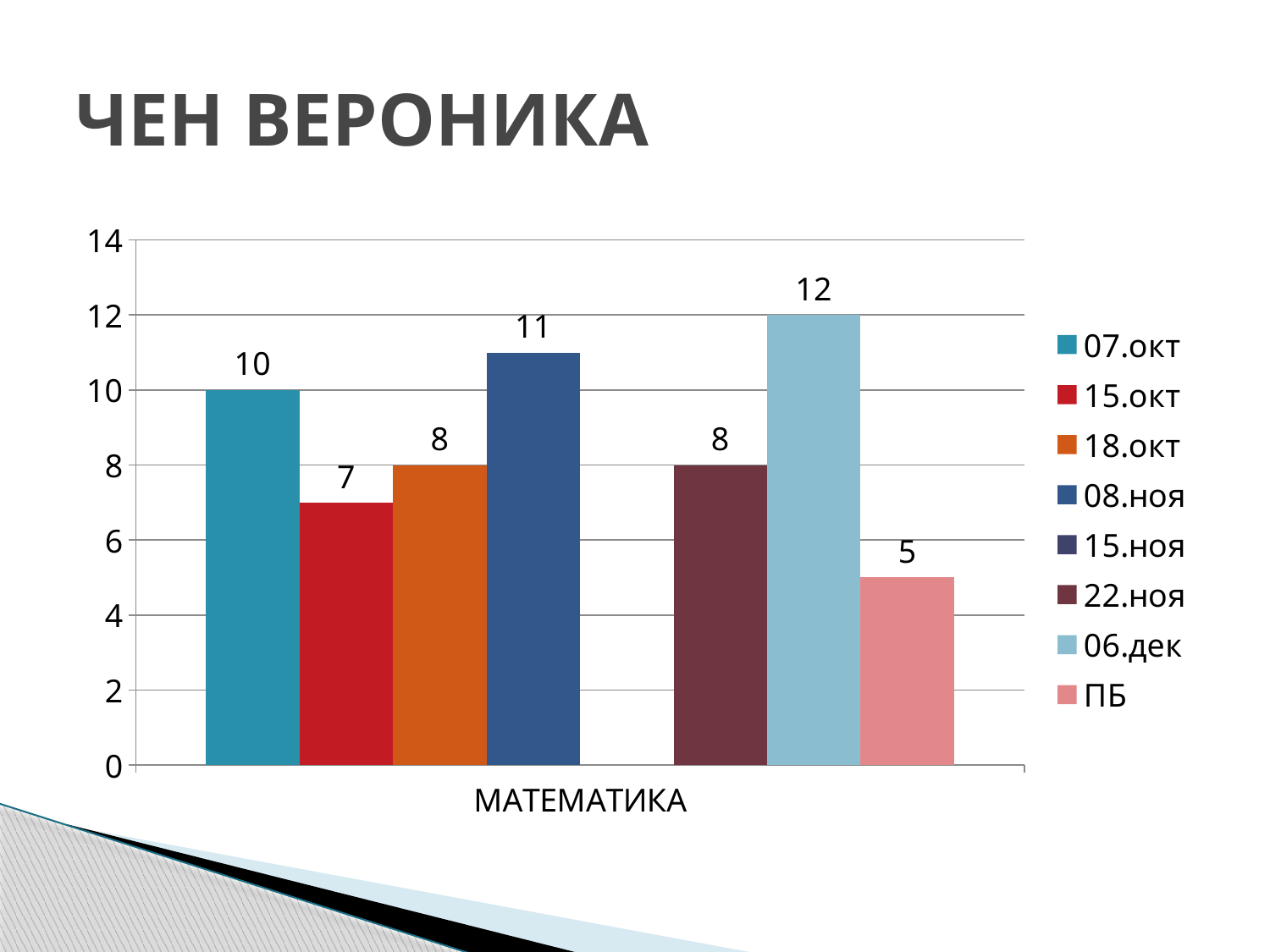
Which is larger, the value for 07.окт or the value for 08.ноя? 08.ноя What is the value for 06.дек? 12 What kind of chart is shown on the slide? bar chart What is the value for 15.окт? 7 What is the value for ПБ? 5 What is the value for 07.окт in the МАТЕМАТИКА chart? 10 What is the value for 08.ноя? 11 How many series does the legend list? 8 What is the difference between the values for 06.дек and ПБ? 7 Which series has the highest value? 06.дек What is the category label shown on the x axis? МАТЕМАТИКА Which series has the lowest plotted value? ПБ